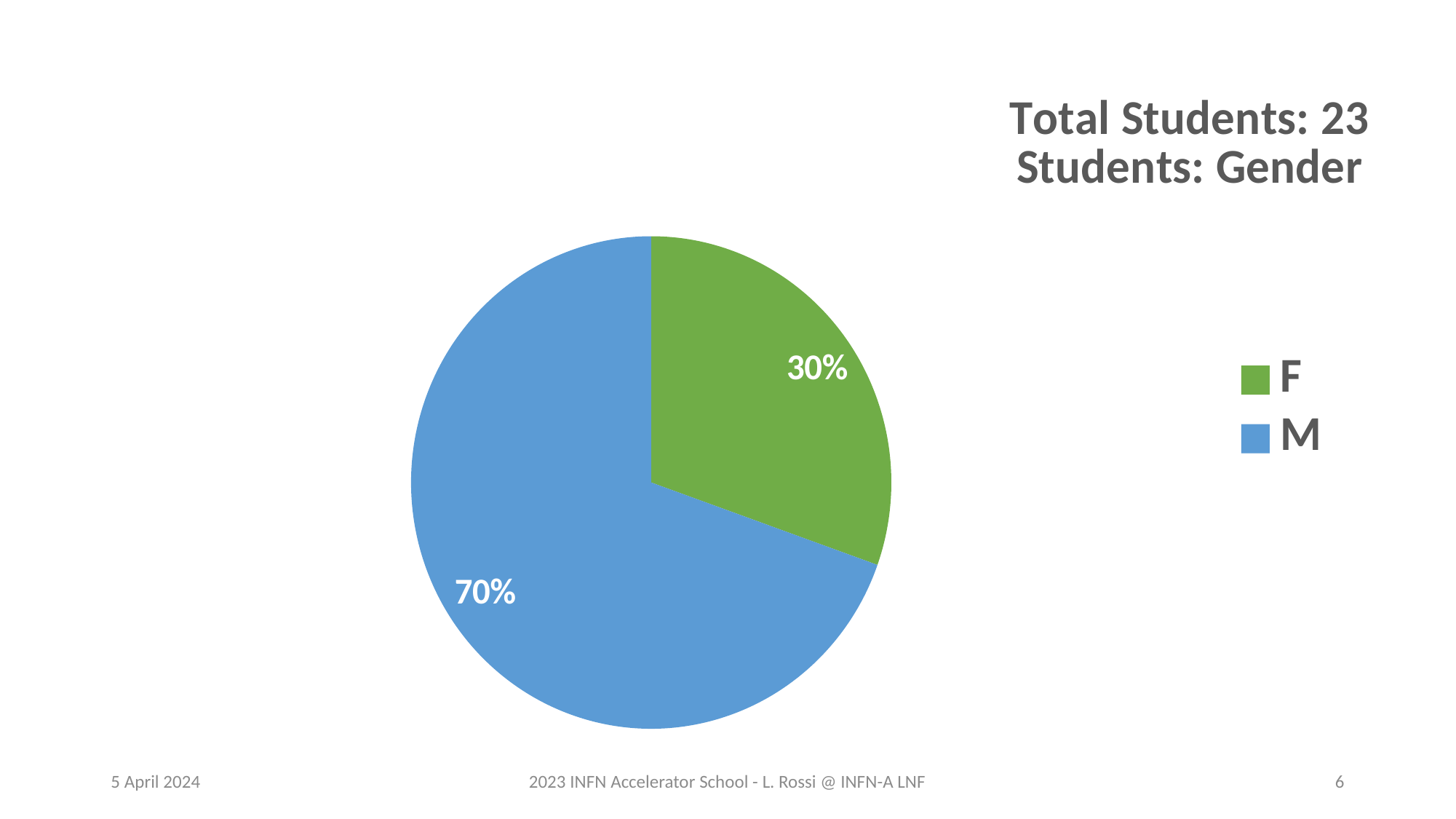
Which category has the largest slice of the pie? M What is the total number of students stated above the chart? 23 What share of the pie does the F slice represent? 30% What colour is the M slice of the pie? blue How many entries does the legend list? 2 What is the difference in percentage points between the M slice and the F slice? 40 Which slice is larger, F or M? M What is the title of the chart? Total Students: 23 Students: Gender Which category has the smallest slice of the pie? F What kind of chart is shown on the slide? pie chart How many slices does the pie chart have? 2 What share of the pie does the M slice represent? 70%